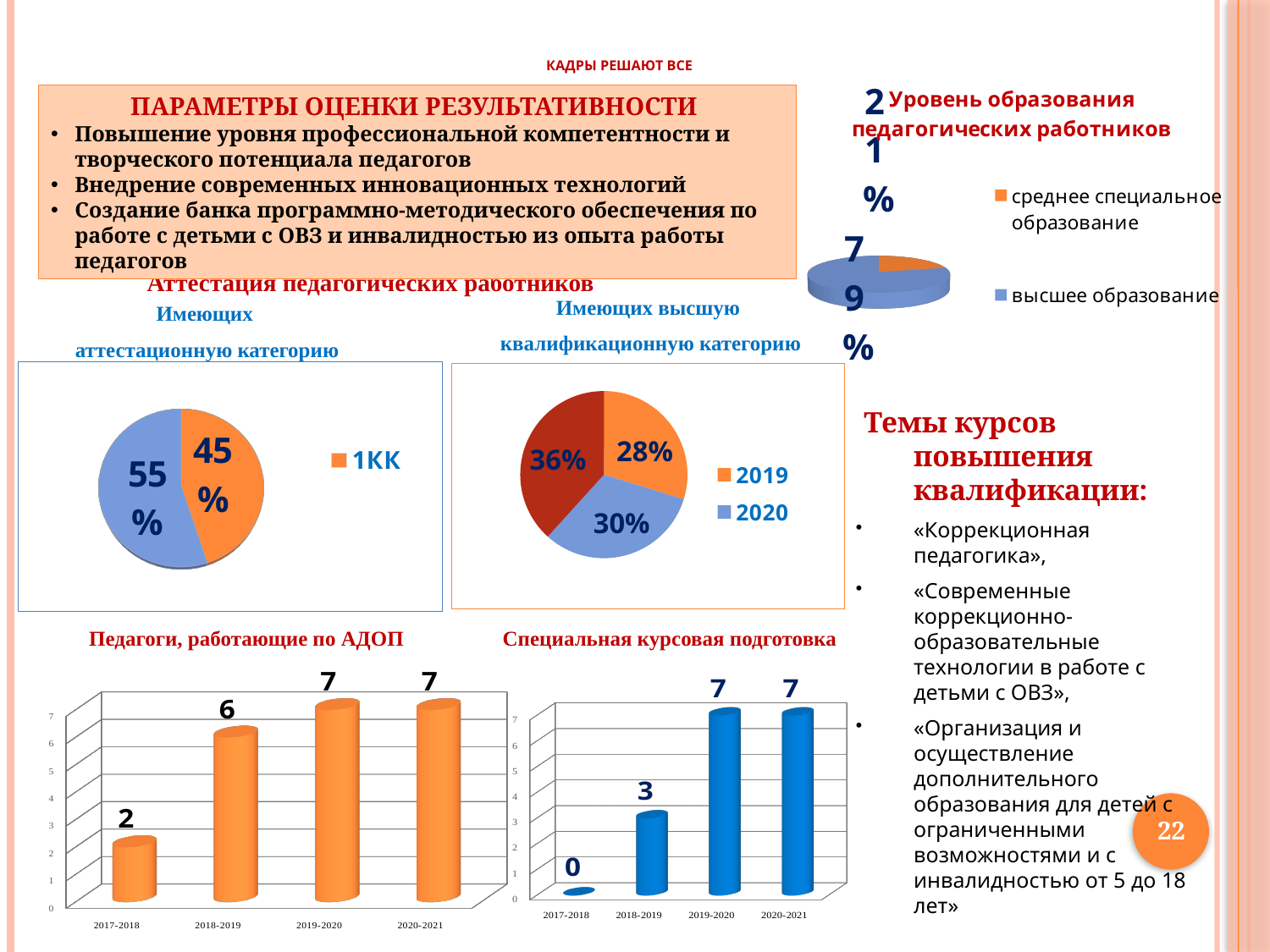
In the chart 'Педагоги, работающие по АДОП', do the values rise or fall from 2017-2018 to 2019-2020? rise What kind of chart is 'Специальная курсовая подготовка'? bar chart In the chart 'Педагоги, работающие по АДОП', what is the difference between the values for 2018-2019 and 2017-2018? 4 In the chart 'Педагоги, работающие по АДОП', what is the value for 2017-2018? 2 In the chart 'Педагоги, работающие по АДОП', how many categories are shown on the x axis? 4 In the chart 'Специальная курсовая подготовка', which year has the lowest value? 2017-2018 In the pie chart 'Уровень образования педагогических работников', what share does 'высшее образование' have? 79% In the pie chart 'Имеющих высшую квалификационную категорию', what share does the 2020 slice have? 30% In the pie chart 'Имеющих аттестационную категорию', what share does the orange slice (1КК) have? 45% In the chart 'Специальная курсовая подготовка', what is the value for 2018-2019? 3 In the chart 'Педагоги, работающие по АДОП', what is the value for 2018-2019? 6 In the chart 'Специальная курсовая подготовка', what is the difference between the values for 2019-2020 and 2018-2019? 4